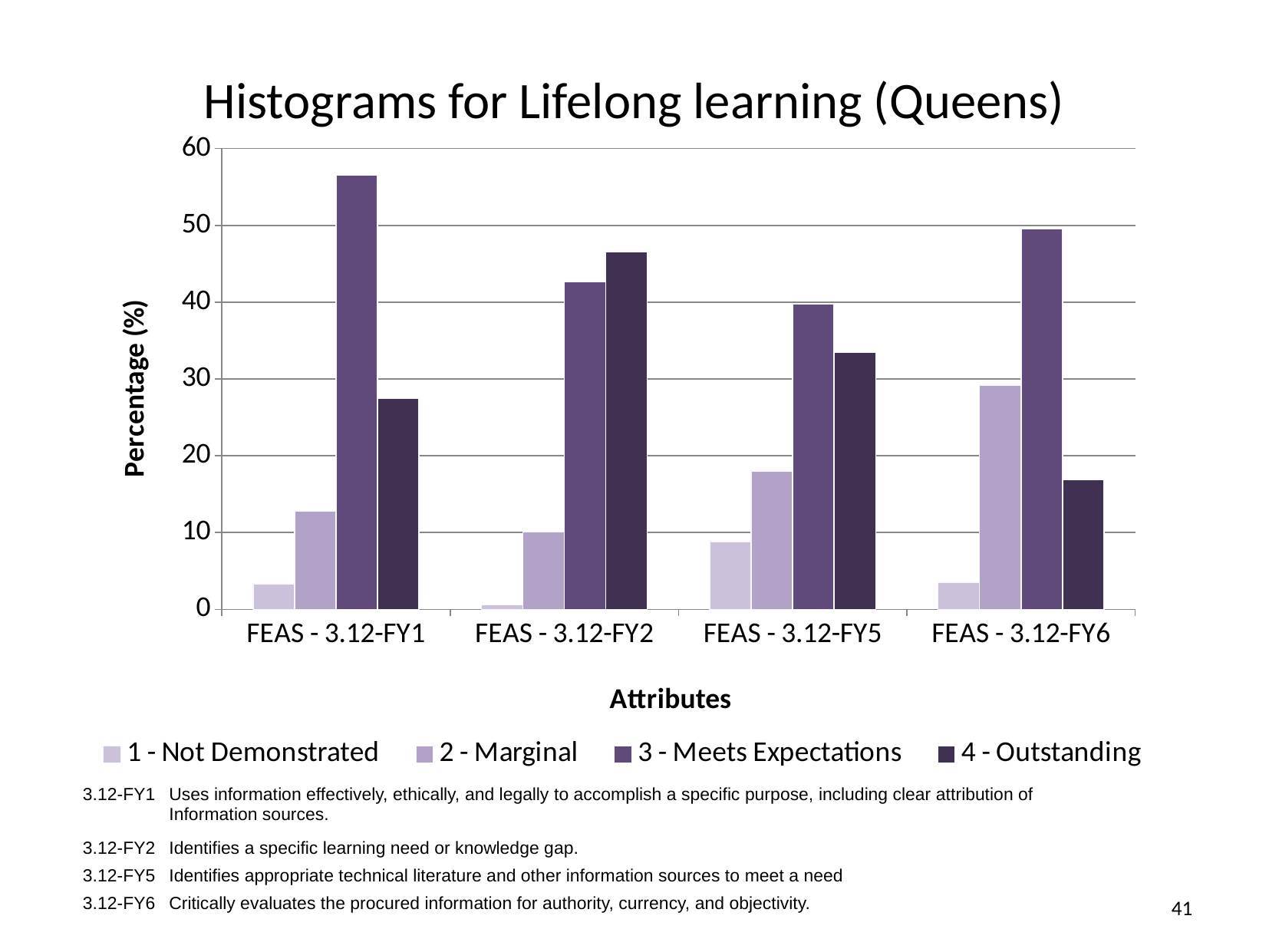
Which attribute has the lowest value for 1 - Not Demonstrated? FEAS - 3.12-FY2 For FEAS - 3.12-FY2, which is larger: 3 - Meets Expectations or 4 - Outstanding? 4 - Outstanding What kind of chart is shown on the slide? bar chart Is the value for 4 - Outstanding at FEAS - 3.12-FY6 greater or less than 20? less Which attribute has the highest value for 3 - Meets Expectations? FEAS - 3.12-FY1 Is the value for 2 - Marginal at FEAS - 3.12-FY6 greater or less than 20? greater How many series does the legend list? 4 Which attribute has the highest value for 2 - Marginal? FEAS - 3.12-FY6 Is the value for 3 - Meets Expectations at FEAS - 3.12-FY1 greater or less than 50? greater What is the title of the x axis? Attributes What is the title of the y axis? Percentage (%) How many attribute categories are shown on the x axis? 4